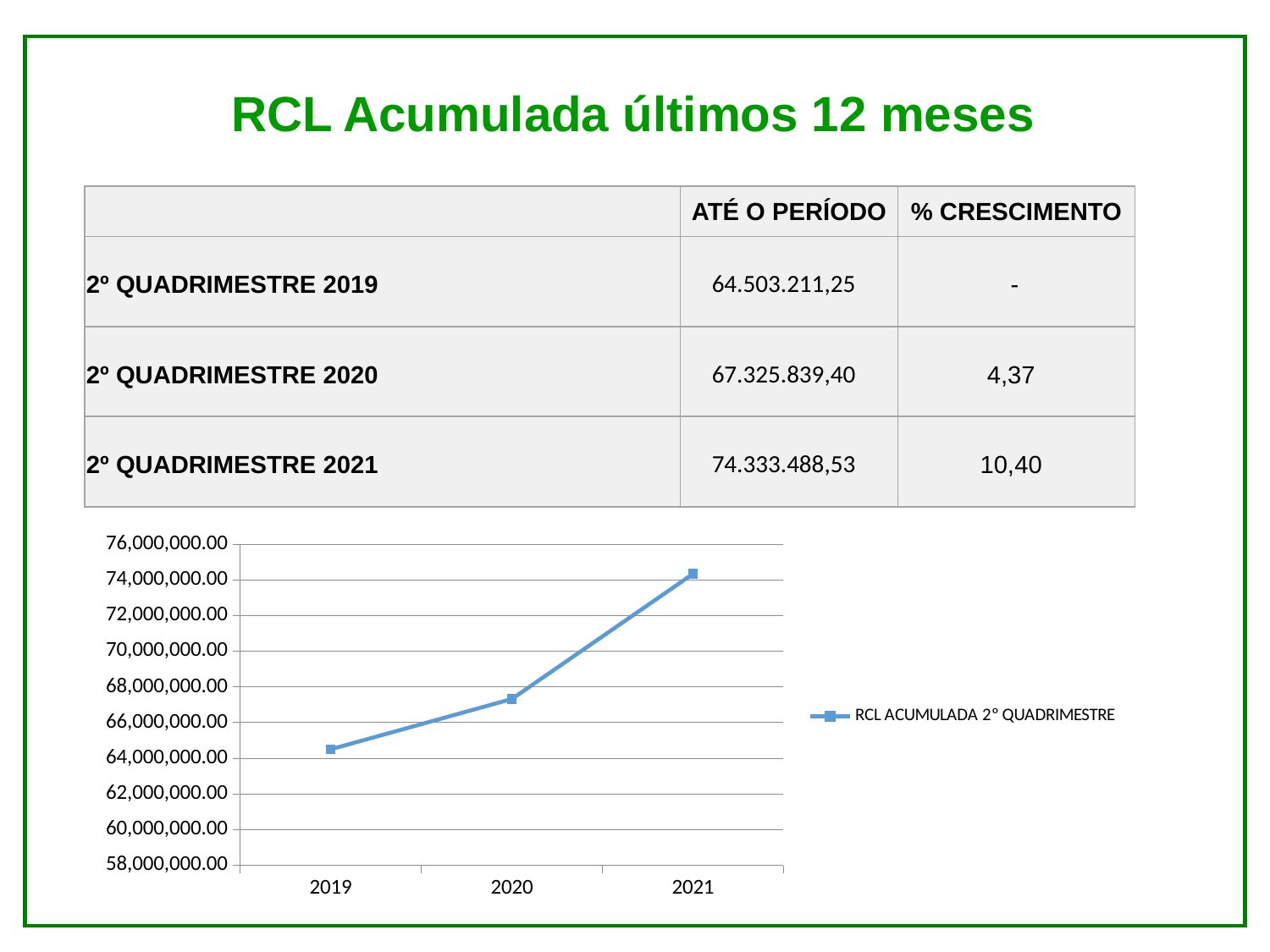
Is the value plotted for 2021 greater or less than 72,000,000.00? greater How many data points are plotted on the line chart? 3 Is the value plotted for 2019 greater or less than 66,000,000.00? less Which year has the highest value in the line chart? 2021 What is the name of the series shown in the chart legend? RCL ACUMULADA 2° QUADRIMESTRE Do the values in the line chart rise or fall from 2019 to 2021? rise Is the value plotted for 2020 greater or less than 66,000,000.00? greater According to the table, what is the RCL accumulated value for 2º QUADRIMESTRE 2021? 74.333.488,53 What kind of chart is shown on the slide? line chart How many series does the chart legend list? 1 According to the table, what is the % CRESCIMENTO for 2º QUADRIMESTRE 2020? 4,37 Which year has the lowest value in the line chart? 2019